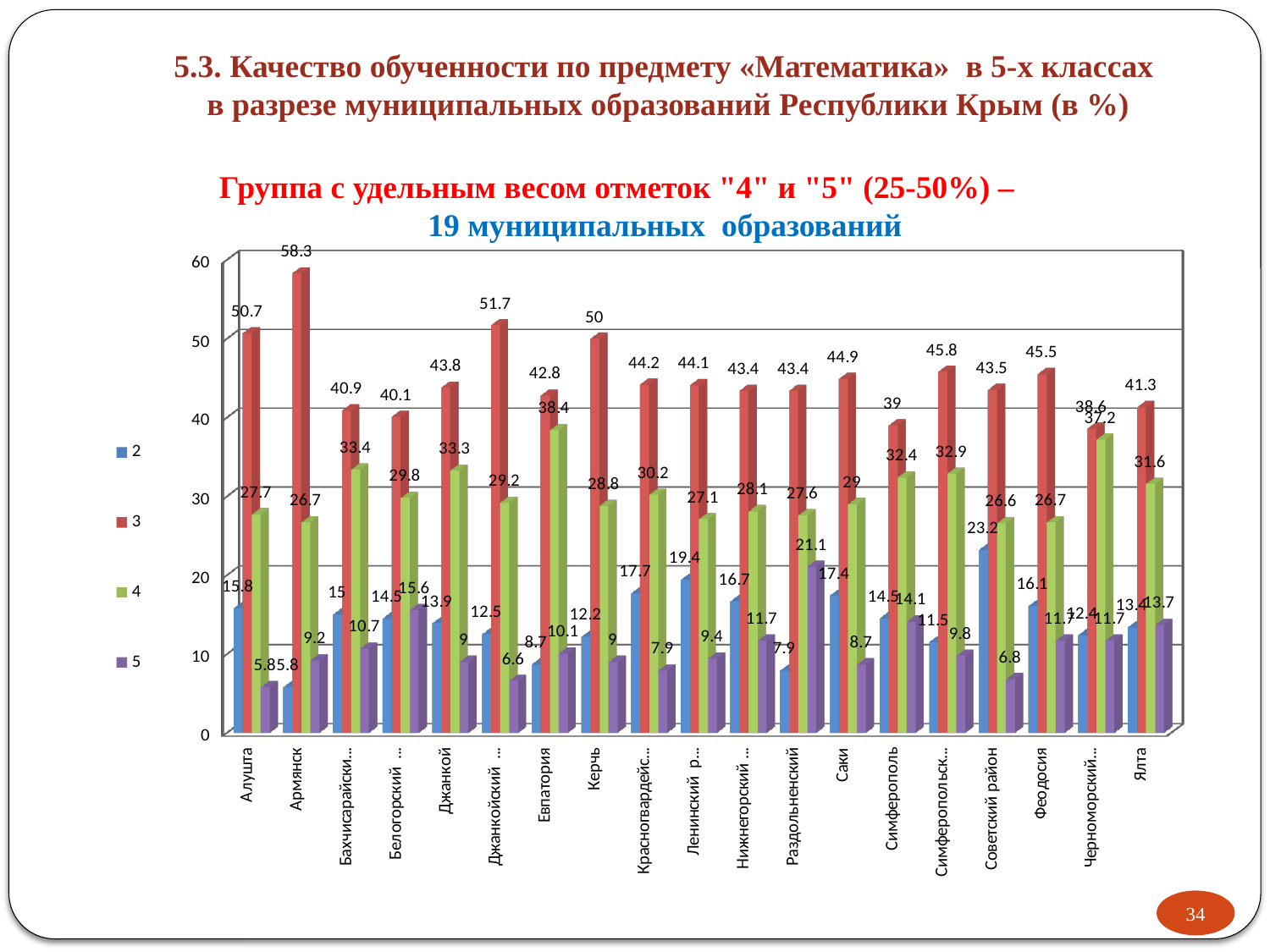
What is the value of series "5" for Раздольненский? 21.1 Which is larger: the series "4" value for Симферополь or the series "4" value for Ялта? Симферополь How many series does the legend list? 4 What is the value of series "3" for Армянск? 58.3 What is the difference between the series "3" value for Алушта and the series "3" value for Керчь? 0.7 What is the value of series "4" for Евпатория? 38.4 How many categories (municipalities) are shown on the x axis? 19 Which category has the highest value for series "3"? Армянск What type of chart is shown on the slide? Bar chart Which category has the highest value for series "2"? Советский район Is the series "3" value for Феодосия greater or less than 40? greater What is the value of series "2" for Советский район? 23.2